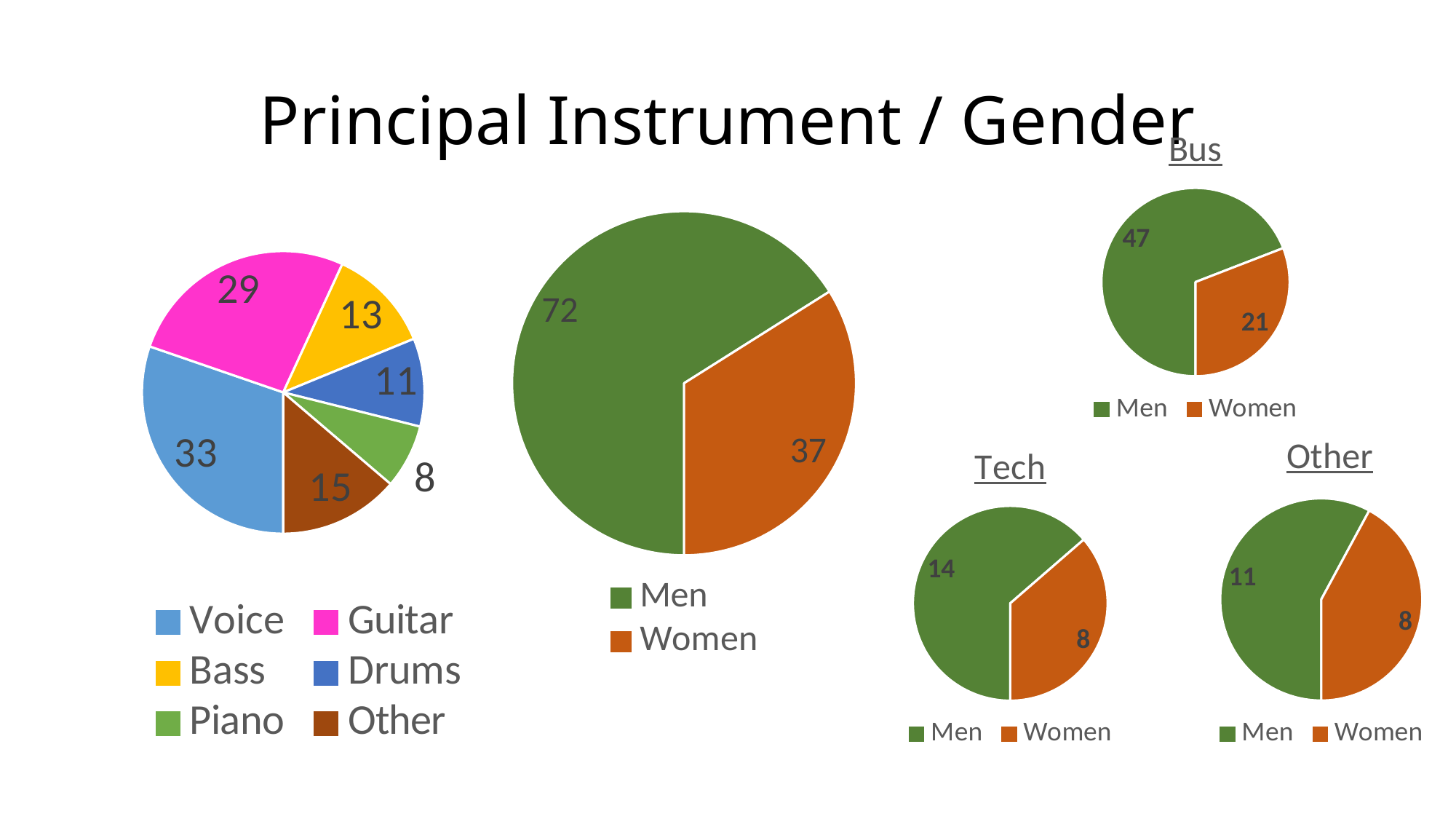
In the pie chart titled Other, what is the value for Women? 8 In the pie chart titled Bus, what is the value for Men? 47 In the pie chart titled Tech, which is larger, Men or Women? Men In the large gender pie chart in the centre of the slide, what is the difference between Men and Women? 35 In the instrument pie chart on the left of the slide, what is the value for Voice? 33 What kind of chart is the chart titled Tech? Pie chart In the instrument pie chart on the left of the slide, what colour is the Guitar slice? Pink How many categories does the legend of the instrument pie chart on the left list? 6 In the instrument pie chart on the left of the slide, what is the difference between the Guitar and Bass values? 16 In the instrument pie chart on the left of the slide, which instrument has the smallest slice? Piano In the large gender pie chart in the centre of the slide, what is the value for Women? 37 In the instrument pie chart on the left of the slide, which instrument has the largest slice? Voice